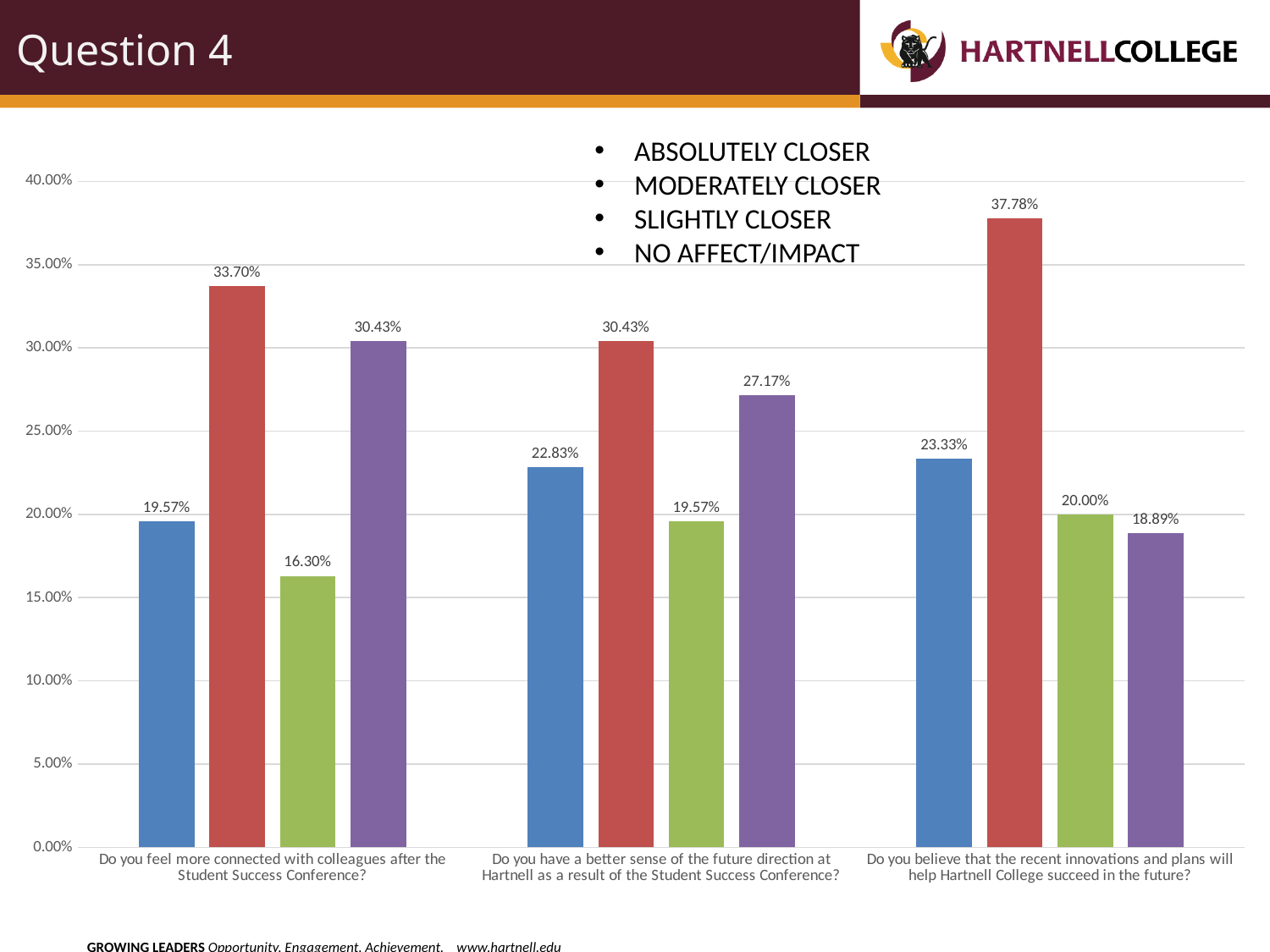
What is the value of the red bar for "Do you believe that the recent innovations and plans will help Hartnell College succeed in the future?"? 37.78% Which bar has the lowest value for "Do you feel more connected with colleagues after the Student Success Conference?"? The green bar (16.30%) What is the value of the green bar for "Do you feel more connected with colleagues after the Student Success Conference?"? 16.30% Is the value of the blue bar for "Do you have a better sense of the future direction at Hartnell as a result of the Student Success Conference?" greater or less than 25.00%? less What is the value of the blue bar for "Do you have a better sense of the future direction at Hartnell as a result of the Student Success Conference?"? 22.83% What type of chart is shown on the slide? Bar chart How many survey questions (categories) are shown on the x axis of the chart? 3 What is the highest value shown anywhere on the chart? 37.78% How many response options are listed in the bulleted legend on the chart? 4 Is the purple bar larger for "Do you feel more connected with colleagues after the Student Success Conference?" or for "Do you have a better sense of the future direction at Hartnell as a result of the Student Success Conference?"? Do you feel more connected with colleagues after the Student Success Conference? (30.43% vs 27.17%) What is the difference between the red bar and the blue bar for "Do you feel more connected with colleagues after the Student Success Conference?"? 14.13% What is the difference between the green bar and the purple bar for "Do you believe that the recent innovations and plans will help Hartnell College succeed in the future?"? 1.11%